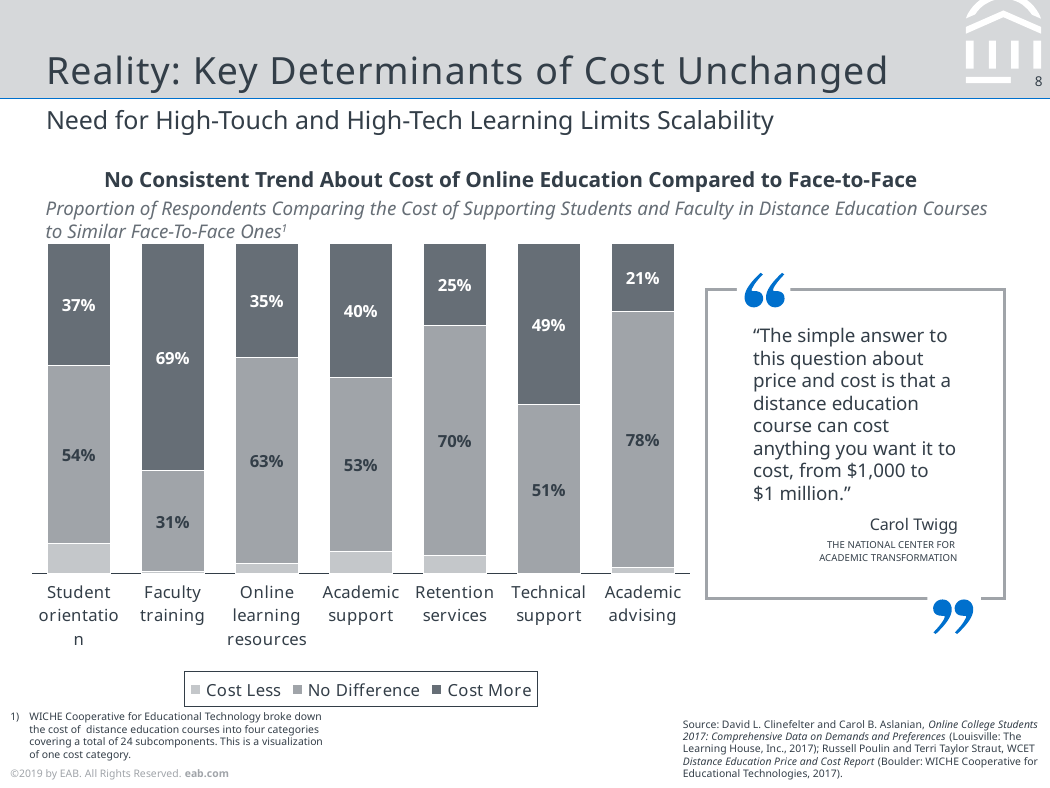
What is the "Cost More" value for Retention services? 25% How many series does the chart legend list? 3 What type of chart is shown on the slide? Stacked bar chart Which is larger for Online learning resources: the "No Difference" value or the "Cost More" value? No Difference What is the "No Difference" value for Academic advising? 78% What is the "No Difference" value for Student orientation? 54% How many categories are shown along the x axis of the chart? 7 Which category has the highest "Cost More" value? Faculty training Which category has the lowest "No Difference" value? Faculty training What are the three legend entries of the chart? Cost Less, No Difference, Cost More For Retention services, what is the difference between the "No Difference" value and the "Cost More" value? 45 percentage points What is the "Cost More" value for Faculty training? 69%